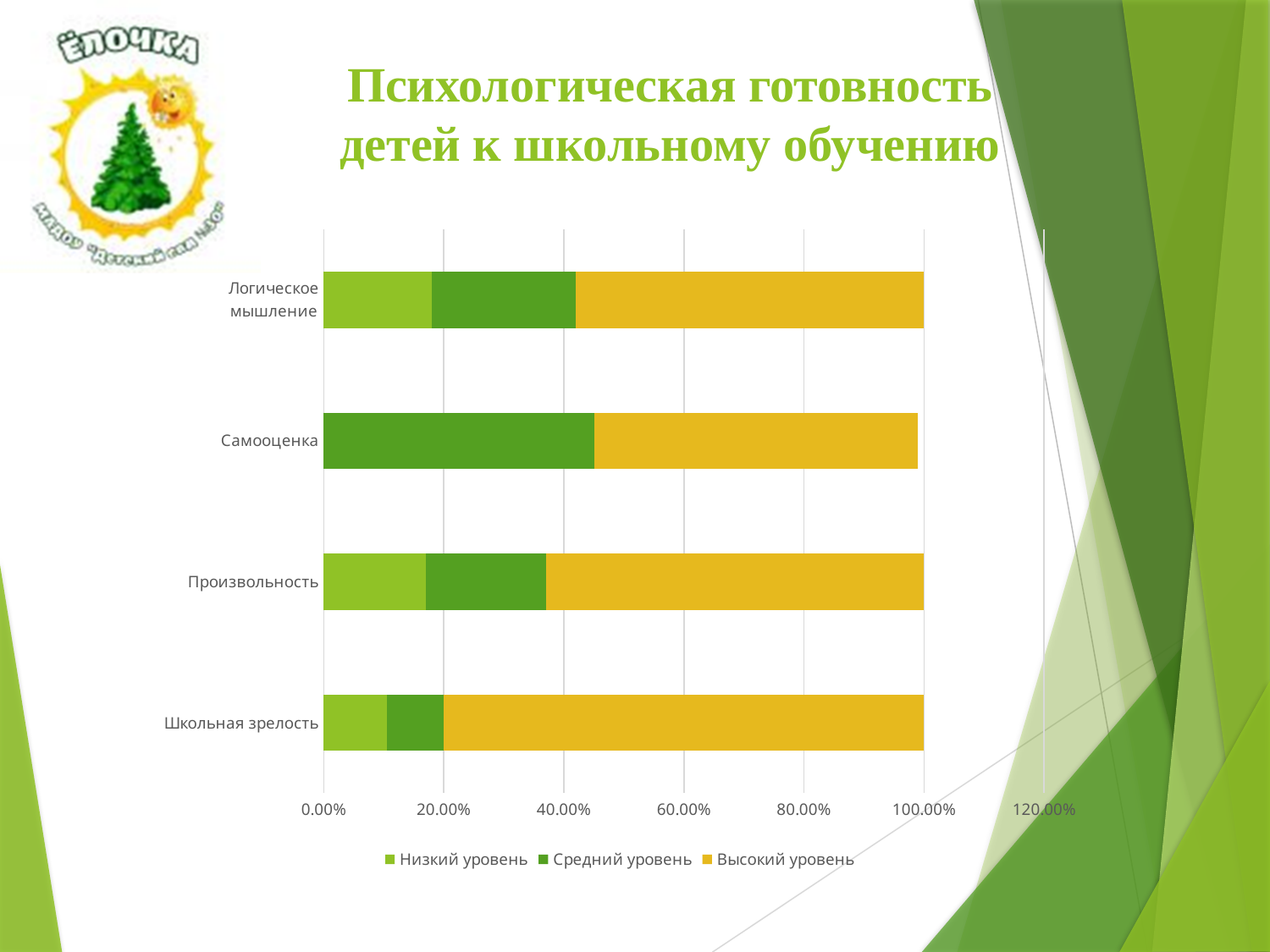
Which category has the smallest Низкий уровень segment? Самооценка What is the highest value shown on the horizontal axis? 120.00% How many series does the legend list? 3 Is the Средний уровень value for Самооценка greater or less than 40.00%? greater Which is larger: the Высокий уровень segment for Школьная зрелость or for Логическое мышление? Школьная зрелость Which is larger: the Низкий уровень segment for Логическое мышление or for Школьная зрелость? Логическое мышление How many categories are shown on the chart? 4 Is the Низкий уровень value for Школьная зрелость greater or less than 20.00%? less Which category has the largest Высокий уровень segment? Школьная зрелость Is the Низкий уровень value for Логическое мышление greater or less than 20.00%? less What are the three series listed in the legend? Низкий уровень, Средний уровень, Высокий уровень What kind of chart is shown on the slide? Stacked bar chart